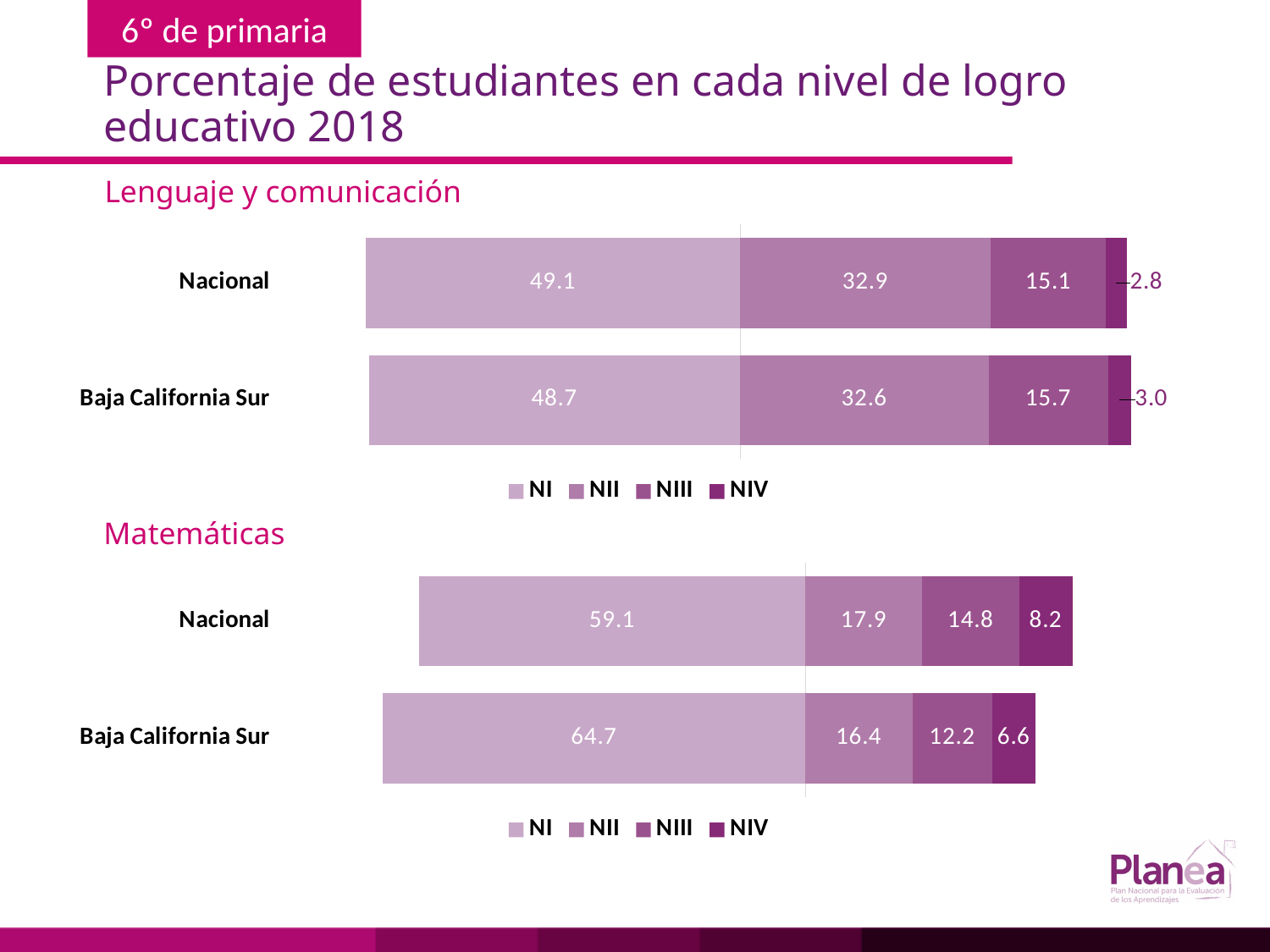
In the Matemáticas chart, what is the total of the stacked bar for Nacional? 100.0 In the Matemáticas chart, what is the NIII value for Nacional? 14.8 In the Lenguaje y comunicación chart, what is the difference between the NIII values for Baja California Sur and Nacional? 0.6 In the Lenguaje y comunicación chart, what is the NIV value for Baja California Sur? 3.0 In the Matemáticas chart, which category has the higher NI value, Nacional or Baja California Sur? Baja California Sur How many series does the legend of the Matemáticas chart list? 4 In the Matemáticas chart, which level has the largest value for Baja California Sur? NI In the Lenguaje y comunicación chart, what is the NI value for Nacional? 49.1 In the Matemáticas chart, what is the NI value for Baja California Sur? 64.7 What type of chart is the Lenguaje y comunicación chart? Stacked bar chart In the Lenguaje y comunicación chart, which level has the smallest value for Nacional? NIV In the Matemáticas chart, what is the difference between the NI values for Baja California Sur and Nacional? 5.6